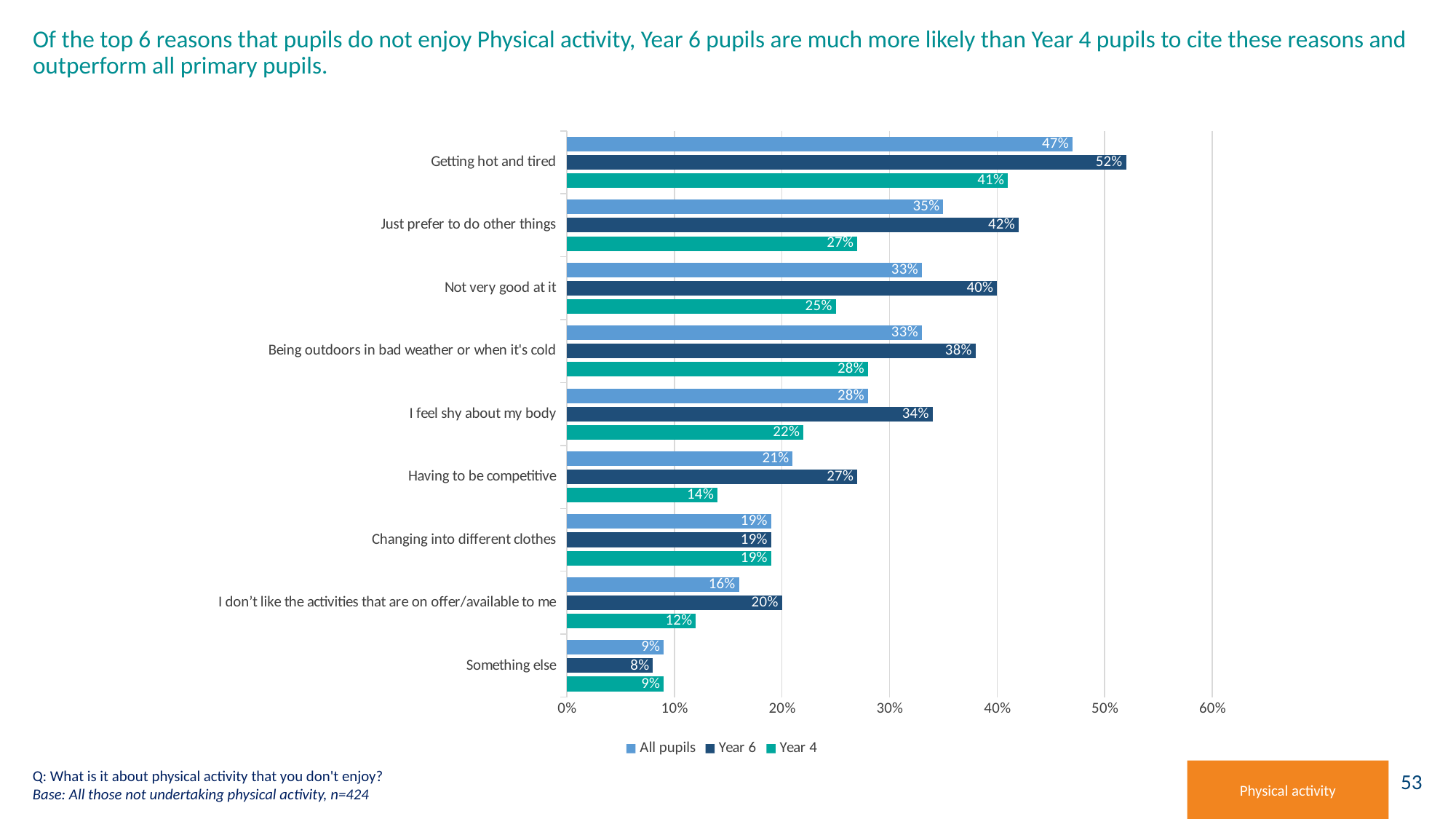
Which series is shown in the darkest blue colour? Year 6 Which category has the lowest Year 4 value? Something else How many series does the legend list? 3 What is the Year 4 value for 'Having to be competitive'? 14% What is the Year 6 value for 'Getting hot and tired'? 52% Which category has the highest Year 6 value? Getting hot and tired What is the All pupils value for 'I feel shy about my body'? 28% What kind of chart is shown on the slide? Bar chart Is the Year 6 value for 'Being outdoors in bad weather or when it's cold' greater or less than 30%? greater Which is larger for 'Not very good at it': the Year 6 value or the Year 4 value? Year 6 How many categories (reasons) are shown on the chart? 9 What is the difference between the Year 6 and Year 4 values for 'Just prefer to do other things'? 15%